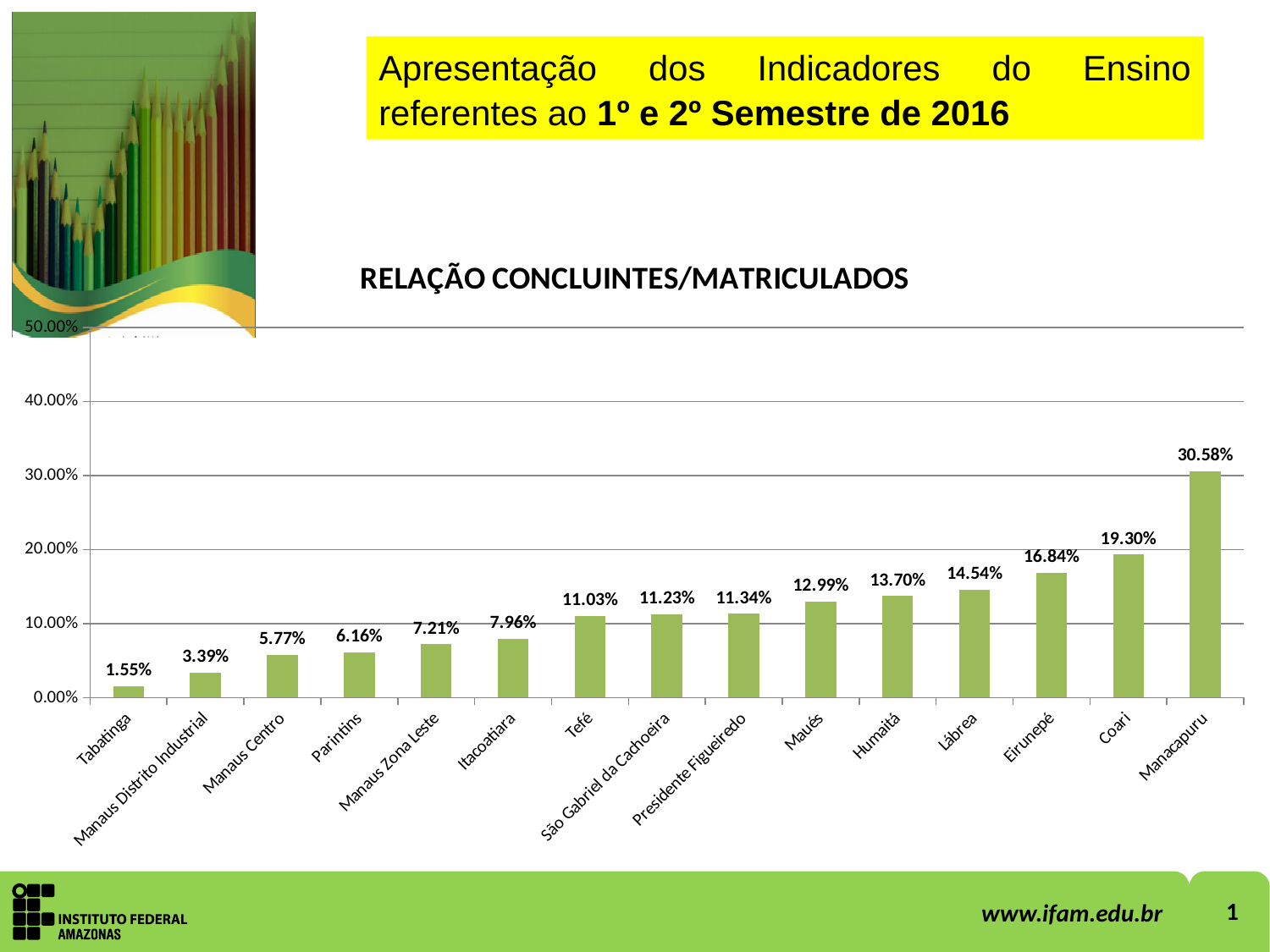
Which category has the lowest value? Tabatinga What is the value for Lábrea? 14.54% How many categories are shown on the x axis? 15 Do the values rise or fall from left to right along the x axis? rise Which is larger, the value for Humaitá or the value for Maués? Humaitá What is the value for Manacapuru? 30.58% What is the value for Manaus Distrito Industrial? 3.39% What is the difference between the values for Coari and Eirunepé? 2.46% What kind of chart is shown on the slide? bar chart Is the value for Coari greater or less than 20.00%? less What is the value for Tefé? 11.03% Which category has the highest value? Manacapuru